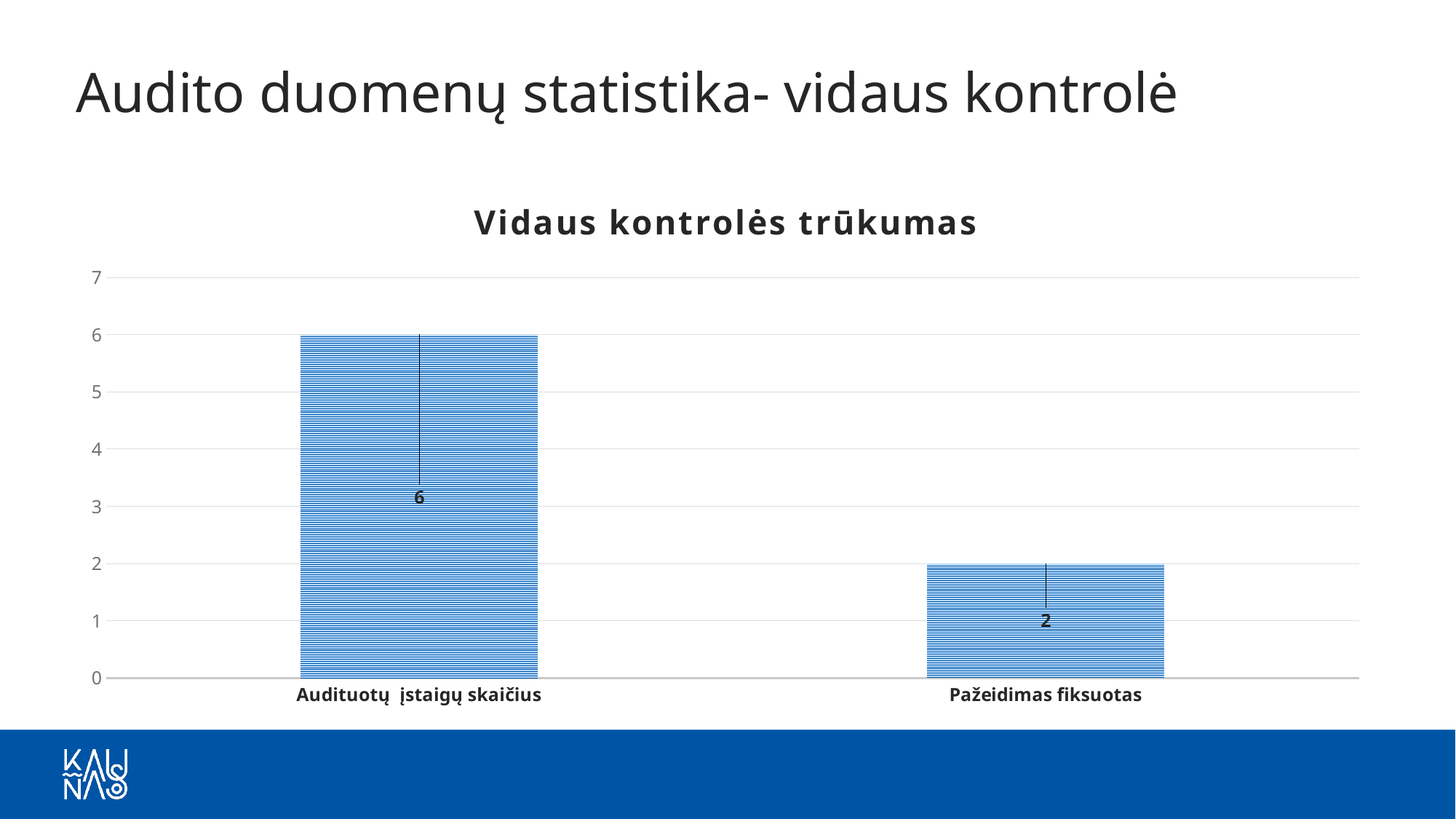
How many categories are shown in the chart? 2 What is the highest value shown on the vertical axis? 7 What kind of chart is shown on the slide? bar chart Which category has the highest value? Audituotų įstaigų skaičius Which category has the lowest value? Pažeidimas fiksuotas What is the difference between the values for "Audituotų įstaigų skaičius" and "Pažeidimas fiksuotas"? 4 Is the value for "Audituotų įstaigų skaičius" greater or less than 5? greater What is the value for "Pažeidimas fiksuotas"? 2 What is the value for "Audituotų įstaigų skaičius"? 6 Is the value for "Pažeidimas fiksuotas" greater or less than 3? less What is the title of the chart? Vidaus kontrolės trūkumas Which is larger: the value for "Audituotų įstaigų skaičius" or for "Pažeidimas fiksuotas"? Audituotų įstaigų skaičius